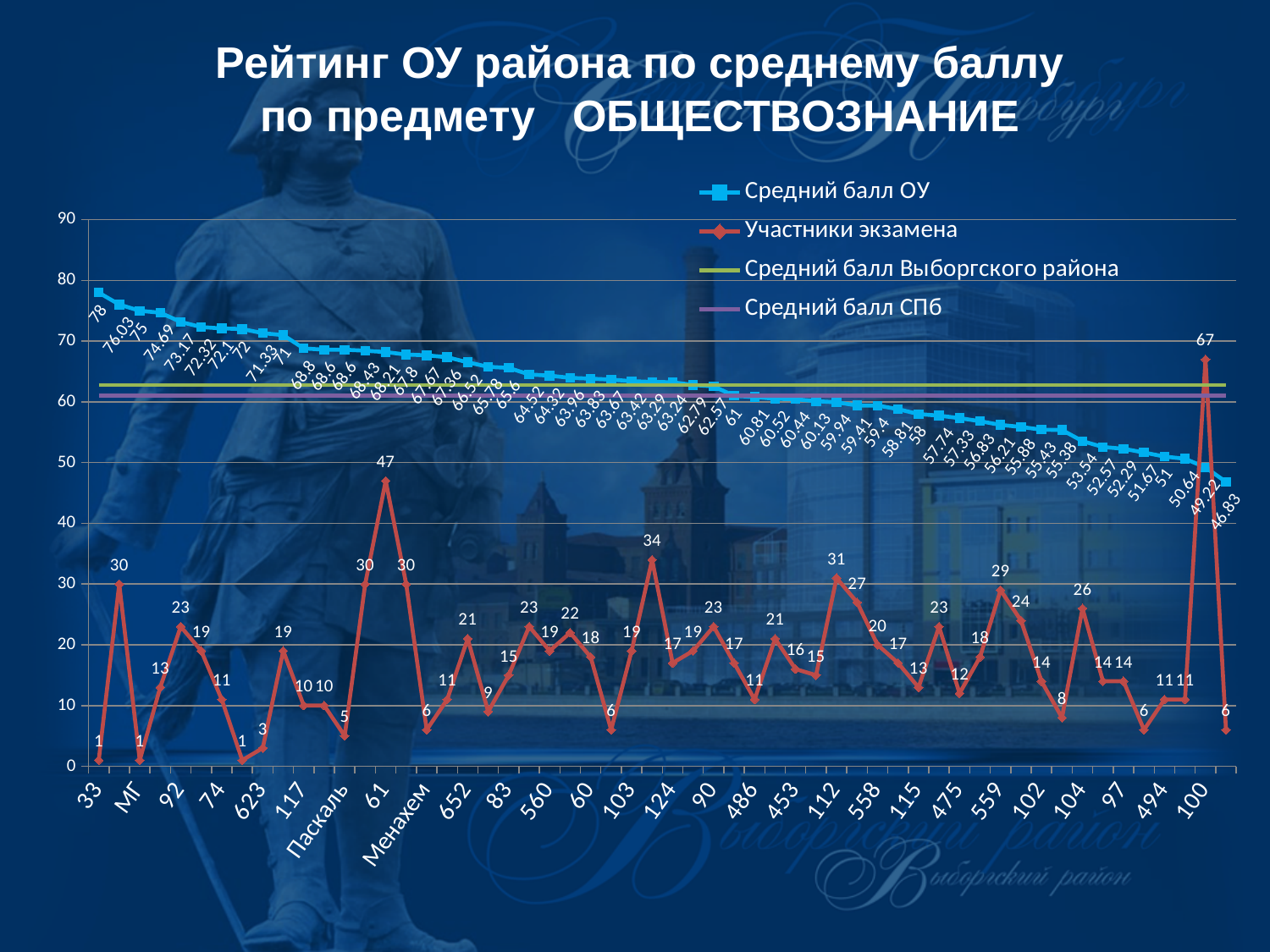
What is the lowest value of the Средний балл ОУ series? 46.83 What is the highest value of the Средний балл ОУ series? 78 Which series is drawn with a purple line? Средний балл СПб What is the value of Средний балл ОУ for the first category, 33? 78 Which is larger in the Участники экзамена series: the peak labelled 47 or the peak labelled 34? 47 How many series does the legend list? 4 Is the Средний балл Выборгского района line greater or less than 60? greater What kind of chart is shown on the slide? line chart What is the value of Участники экзамена for the first category, 33? 1 Does the Средний балл ОУ series rise or fall along the x axis? fall What is the difference between the highest and lowest values of the Средний балл ОУ series? 31.17 What is the highest value of the Участники экзамена series? 67